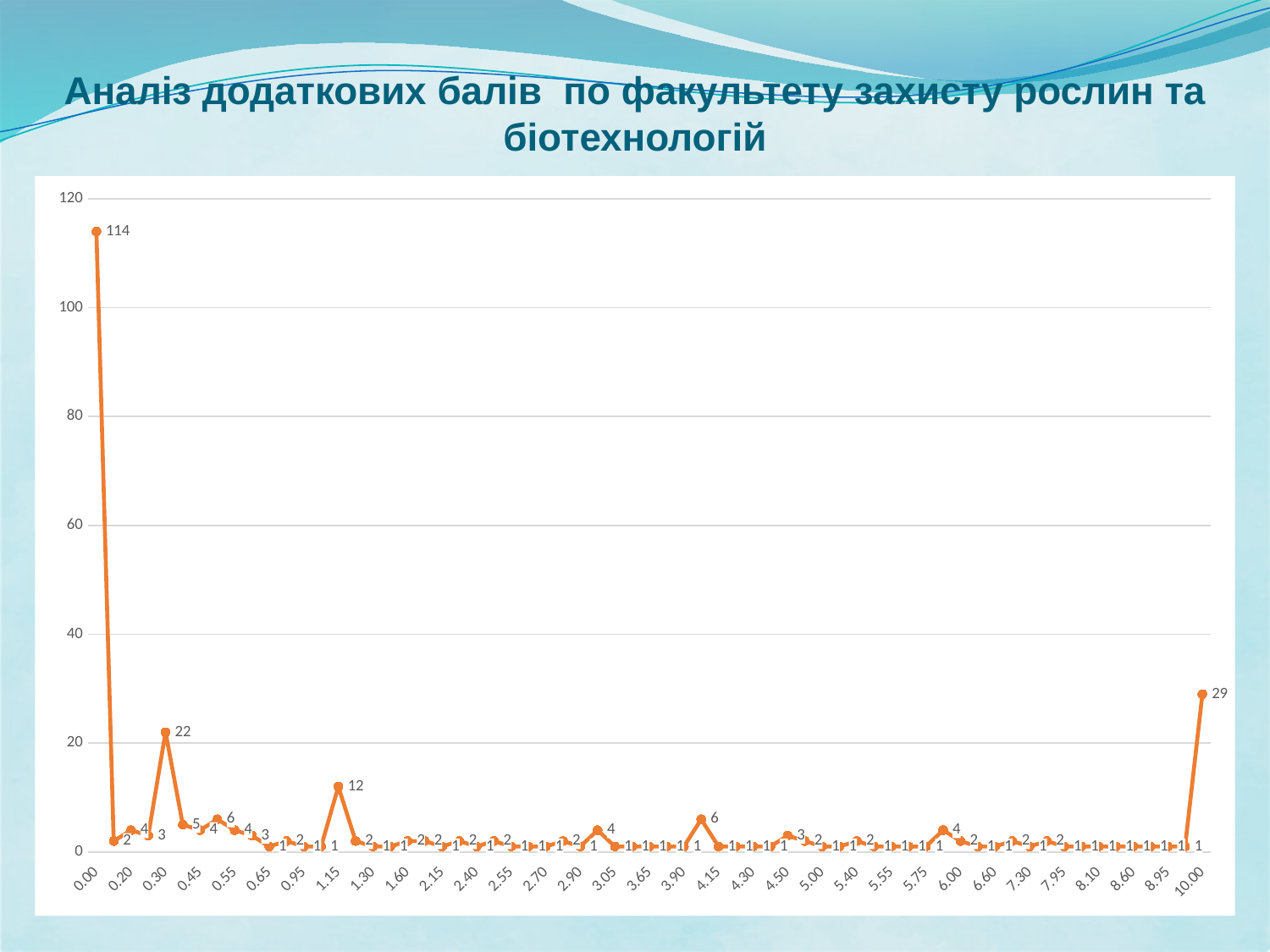
What is the value plotted at 10.00? 29 What is the difference between the value at 0.30 and the value at 1.15? 10 At which x-axis category is the plotted value highest? 0.00 What is the value plotted at 0.30? 22 What is the value plotted at 1.15? 12 What kind of chart is shown on the slide? line chart What is the title of the slide? Аналіз додаткових балів по факультету захисту рослин та біотехнологій What is the value plotted at 0.00? 114 Is the value at 0.30 greater or less than 40? less Which is larger, the value at 0.30 or the value at 10.00? 10.00 What is the difference between the value at 0.00 and the value at 10.00? 85 Is the value at 10.00 greater or less than 20? greater